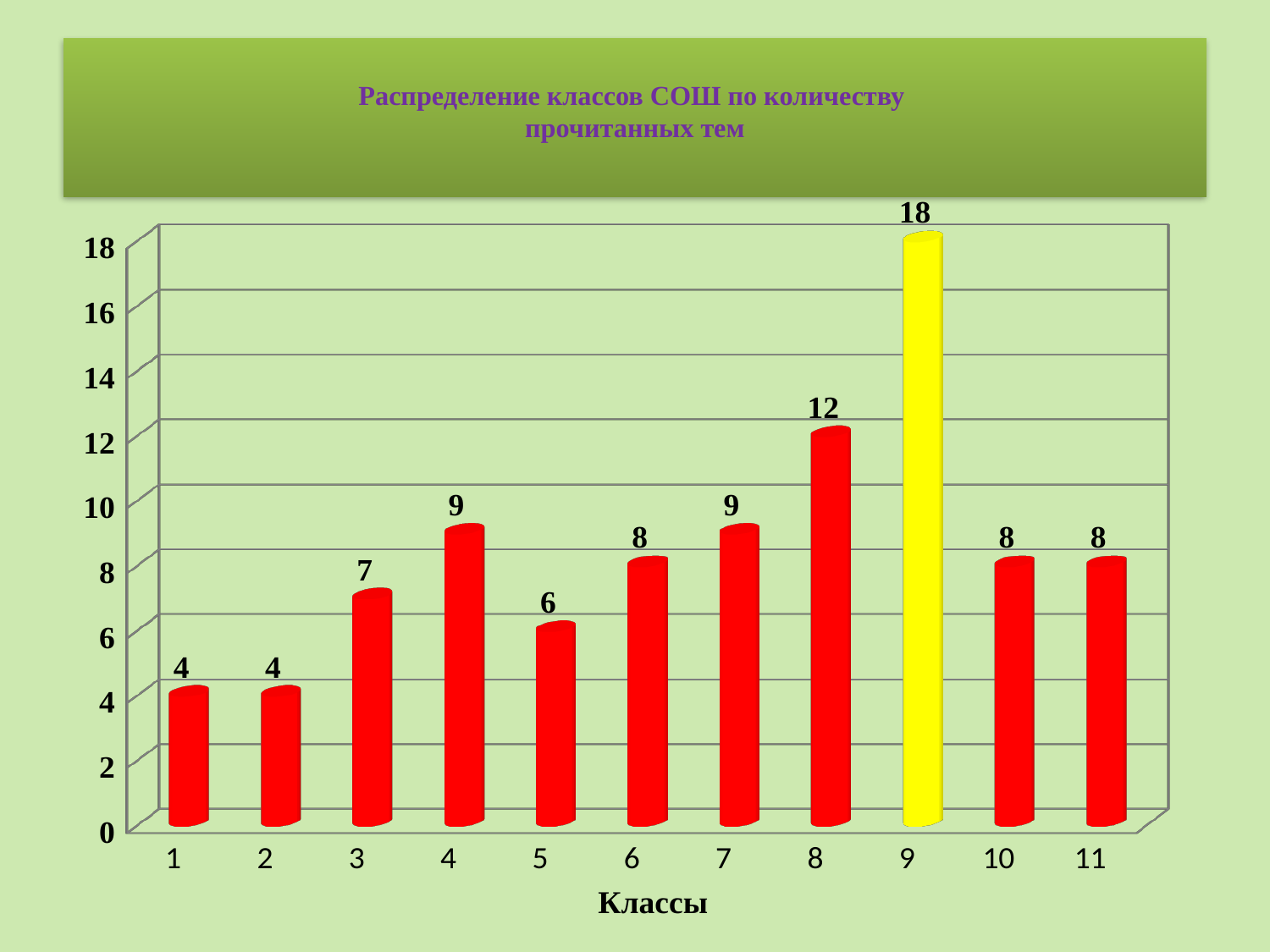
Is the value for class 8 greater or less than 10? greater What is the value for class 5? 6 What is the value for class 9? 18 What is the difference between the values for class 9 and class 8? 6 What is the label of the x axis? Классы Which class has the highest value? 9 How many classes are shown on the x axis? 11 Which is larger, the value for class 6 or the value for class 5? class 6 What is the difference between the values for class 4 and class 1? 5 Which bar is coloured yellow instead of red? class 9 What is the value for class 3? 7 What kind of chart is shown on the slide? bar chart